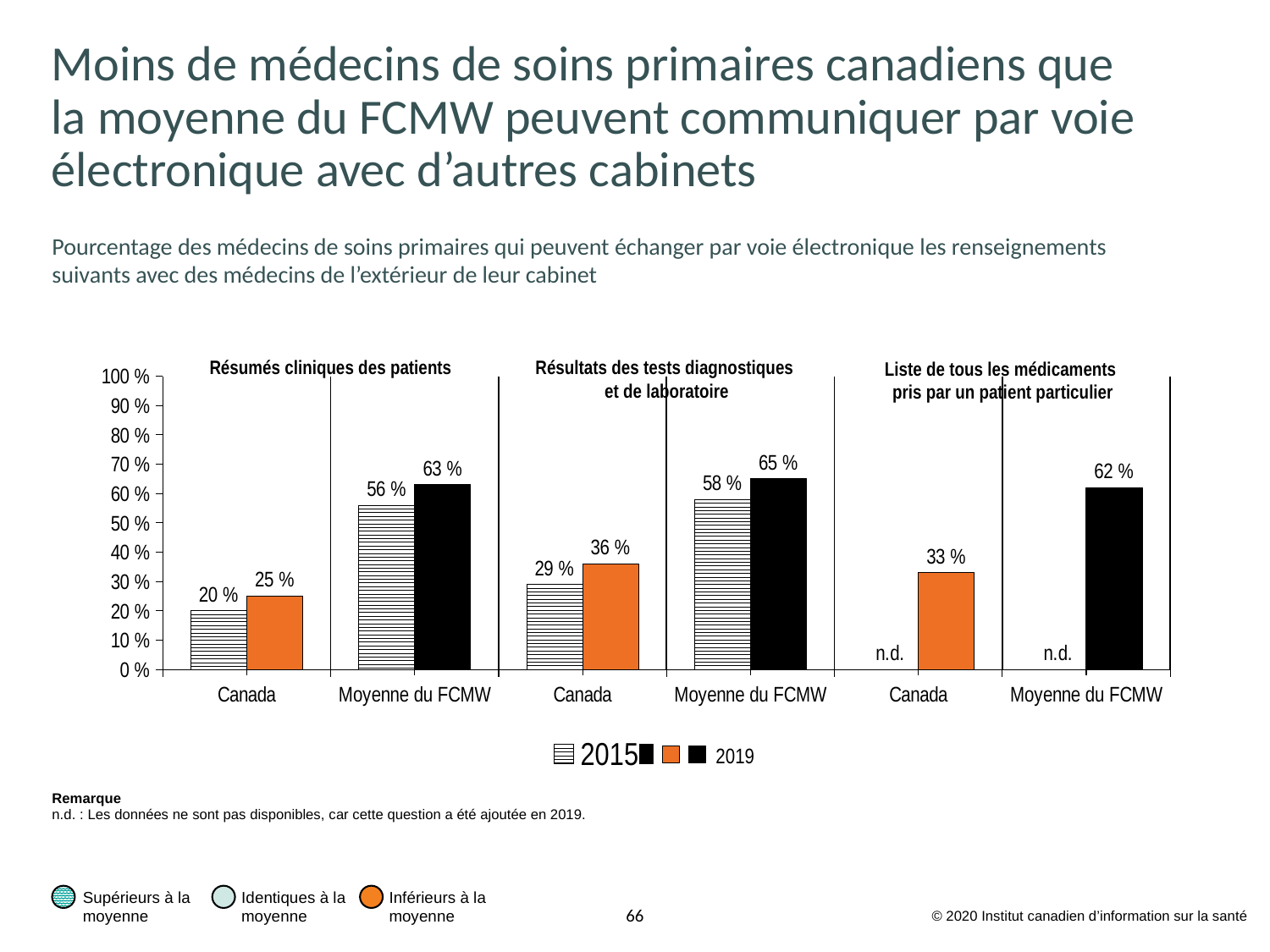
What is the 2019 value for Canada under "Résumés cliniques des patients"? 25 % What is the 2019 value for Moyenne du FCMW under "Liste de tous les médicaments pris par un patient particulier"? 62 % Which bar has the highest value on the chart? Moyenne du FCMW, 2019, Résultats des tests diagnostiques et de laboratoire (65 %) How many series does the legend list? 2 What is shown for Canada in 2015 under "Liste de tous les médicaments pris par un patient particulier"? n.d. Did Canada's value for "Résumés cliniques des patients" rise or fall from 2015 to 2019? Rise Under "Résultats des tests diagnostiques et de laboratoire", by how much did Canada's value increase from 2015 to 2019? 7 % Which bar has the lowest value on the chart? Canada, 2015, Résumés cliniques des patients (20 %) What kind of chart is shown on the slide? Bar chart What is the difference between the 2019 values for Moyenne du FCMW and Canada under "Résumés cliniques des patients"? 38 % What is the 2015 value for Moyenne du FCMW under "Résultats des tests diagnostiques et de laboratoire"? 58 % Under "Liste de tous les médicaments pris par un patient particulier", which is larger in 2019: Canada or Moyenne du FCMW? Moyenne du FCMW